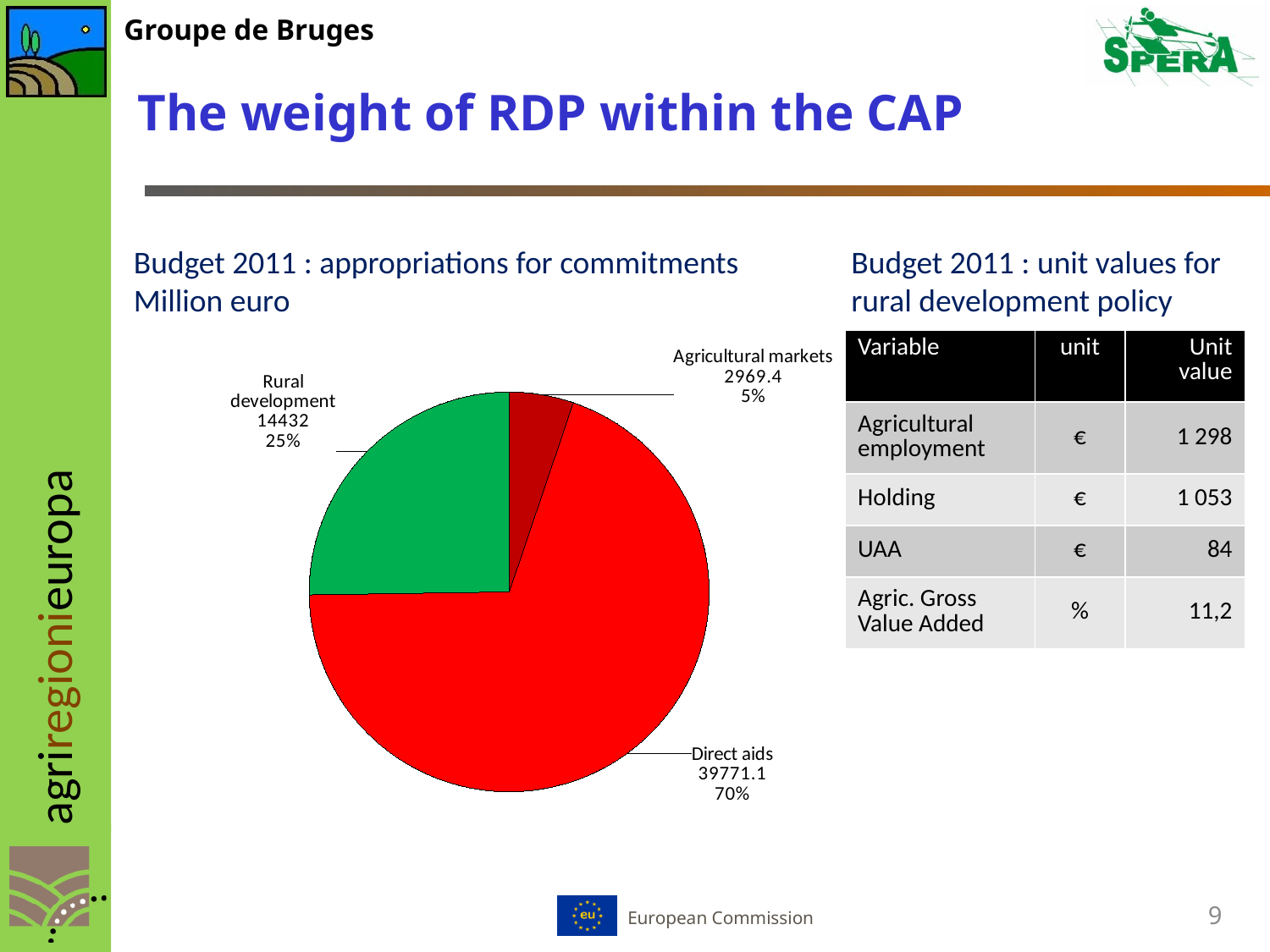
What is the value for Rural development in the pie chart? 14432 What is the value for Direct aids in the pie chart? 39771.1 What share of the pie does Rural development represent? 25% What kind of chart is shown on the slide? pie chart What unit is stated under the pie chart's title? Million euro Which category has the largest slice of the pie chart? Direct aids What is the value for Agricultural markets in the pie chart? 2969.4 What is the difference between the values for Direct aids and Rural development in the pie chart? 25339.1 Which is larger in the pie chart, Rural development or Agricultural markets? Rural development What share of the pie does Direct aids represent? 70% How many slices does the pie chart have? 3 Which category has the smallest slice of the pie chart? Agricultural markets